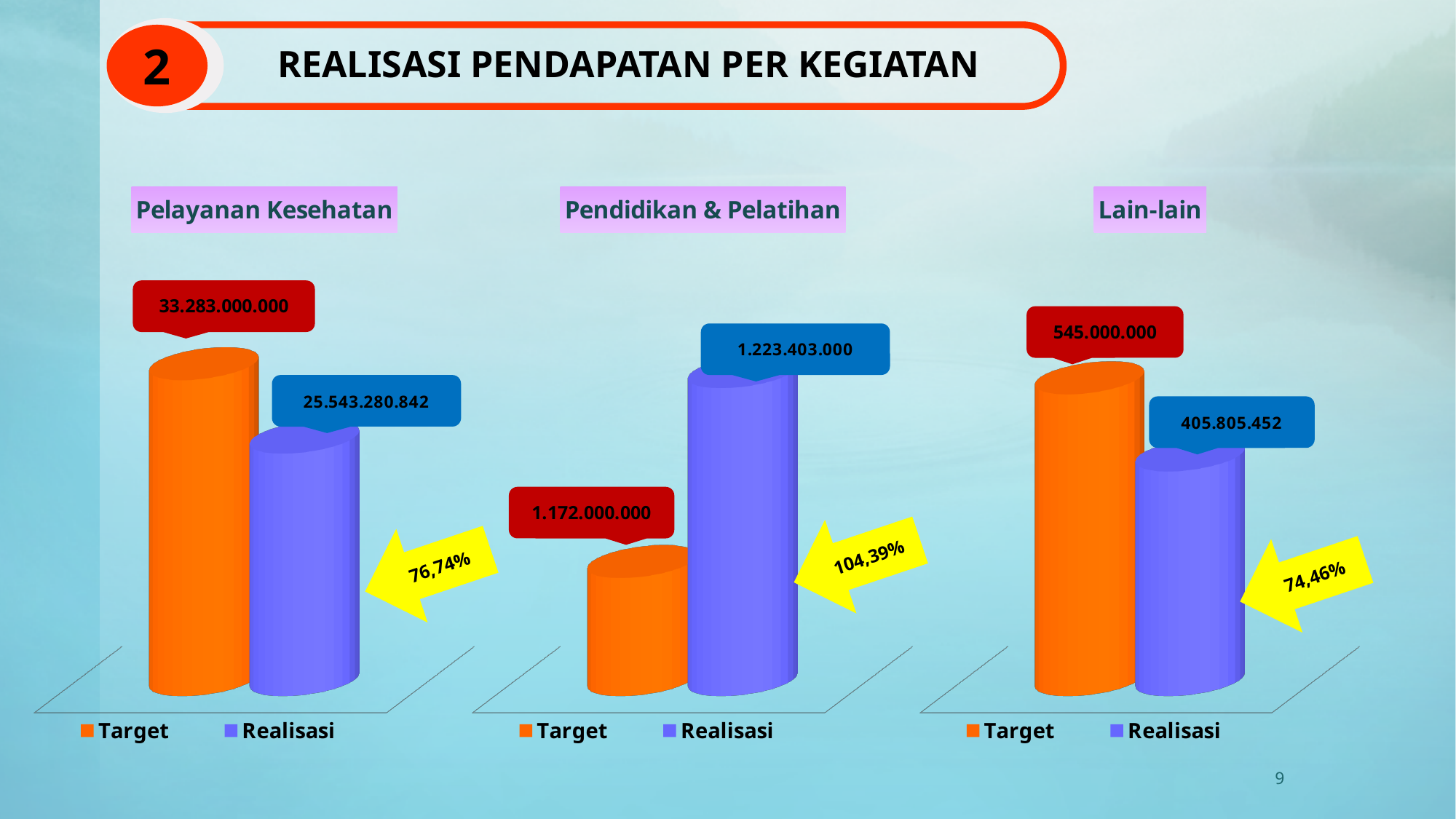
In the Pelayanan Kesehatan chart, what is the value of Target? 33.283.000.000 In the Lain-lain chart, what is the difference between Target and Realisasi? 139.194.548 In the Pelayanan Kesehatan chart, what is the difference between Target and Realisasi? 7.739.719.158 In the Pendidikan & Pelatihan chart, what is the value of Realisasi? 1.223.403.000 In the Lain-lain chart, which is larger, Target or Realisasi? Target In the Pendidikan & Pelatihan chart, what is the difference between Realisasi and Target? 51.403.000 What kind of chart is the Lain-lain chart? Bar chart In the Pelayanan Kesehatan chart, what is the value of Realisasi? 25.543.280.842 In the Pendidikan & Pelatihan chart, which is larger, Target or Realisasi? Realisasi What percentage is shown in the yellow arrow next to the Pendidikan & Pelatihan chart? 104,39% How many series does the legend of the Pelayanan Kesehatan chart list? 2 In the Lain-lain chart, what is the value of Target? 545.000.000